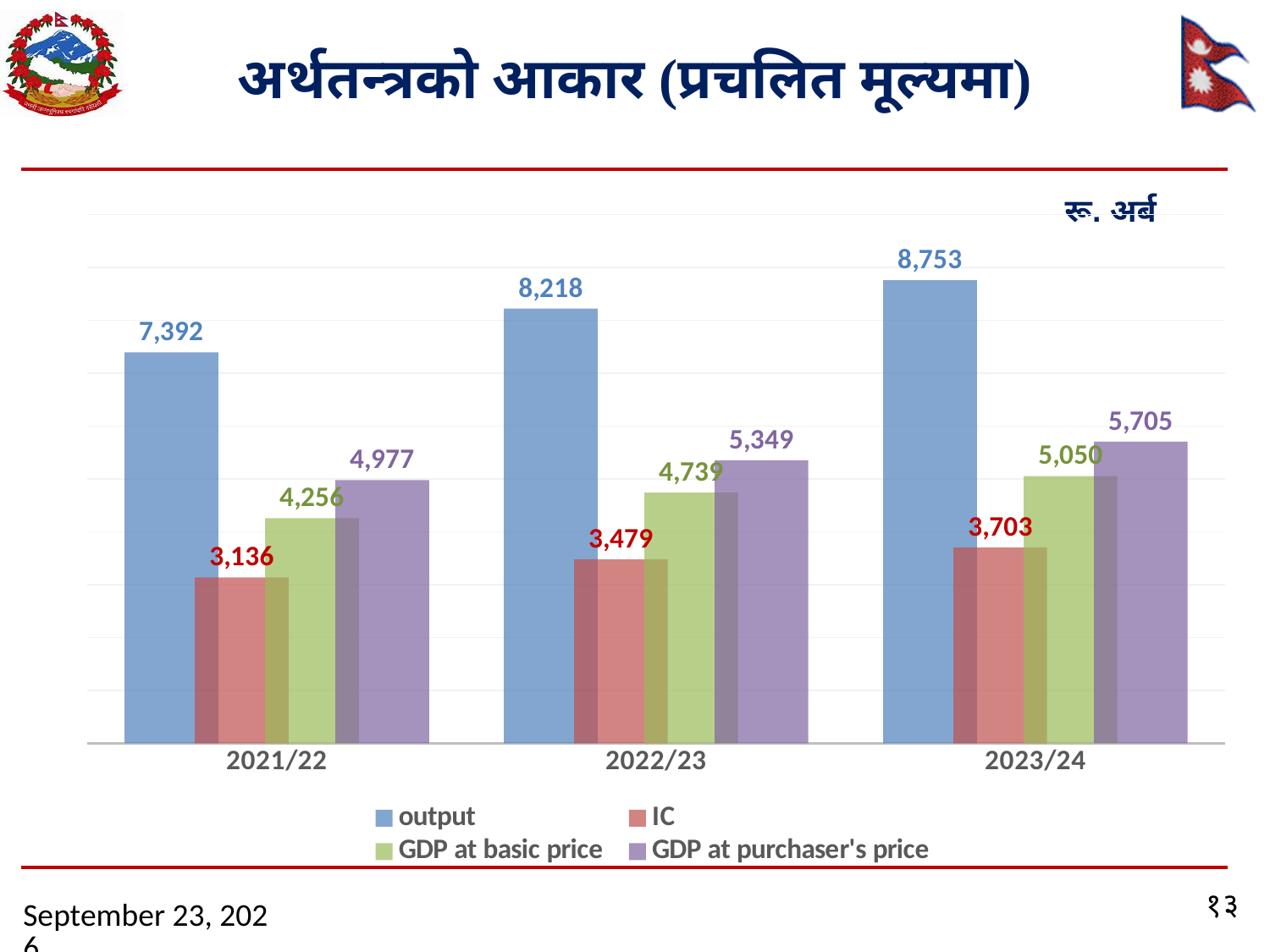
In which year is output highest? 2023/24 What is the value of IC for 2021/22? 3,136 How many series does the legend list? 4 What is the value of GDP at purchaser's price for 2022/23? 5,349 What is the value of output for 2022/23? 8,218 What is the value of GDP at basic price for 2023/24? 5,050 What is the difference between output in 2023/24 and output in 2021/22? 1,361 What kind of chart is shown on the slide? Bar chart Which is larger in 2022/23: GDP at basic price or IC? GDP at basic price In which year is IC lowest? 2021/22 Does GDP at purchaser's price rise or fall from 2021/22 to 2023/24? Rise How many years are shown on the x axis? 3